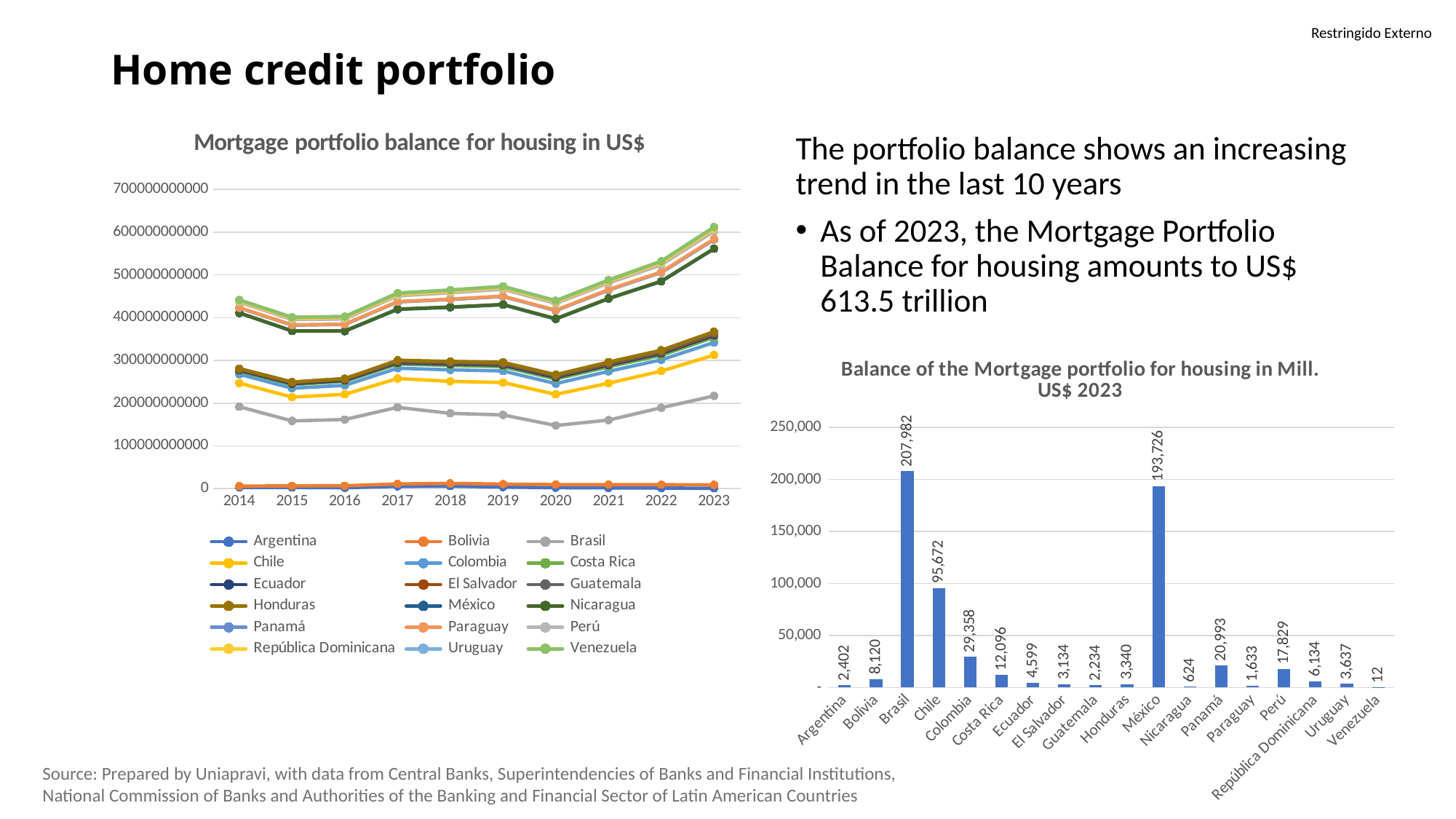
In the bar chart 'Balance of the Mortgage portfolio for housing in Mill. US$ 2023', which country has the lowest value? Venezuela In the bar chart 'Balance of the Mortgage portfolio for housing in Mill. US$ 2023', how many countries are shown? 18 How many series does the legend of the line chart 'Mortgage portfolio balance for housing in US$' list? 18 In the bar chart 'Balance of the Mortgage portfolio for housing in Mill. US$ 2023', what is the value for Colombia? 29,358 In the bar chart 'Balance of the Mortgage portfolio for housing in Mill. US$ 2023', which is larger, the value for Panamá or the value for Perú? Panamá In the bar chart 'Balance of the Mortgage portfolio for housing in Mill. US$ 2023', what is the difference between the values for Chile and Colombia? 66,314 In the bar chart 'Balance of the Mortgage portfolio for housing in Mill. US$ 2023', what is the difference between the values for Brasil and México? 14,256 What kind of chart is the chart titled 'Mortgage portfolio balance for housing in US$'? Line chart In the bar chart 'Balance of the Mortgage portfolio for housing in Mill. US$ 2023', which country has the highest value? Brasil How many years are shown on the x axis of the line chart 'Mortgage portfolio balance for housing in US$'? 10 In the bar chart 'Balance of the Mortgage portfolio for housing in Mill. US$ 2023', what is the value for Brasil? 207,982 In the bar chart 'Balance of the Mortgage portfolio for housing in Mill. US$ 2023', what is the value for Perú? 17,829